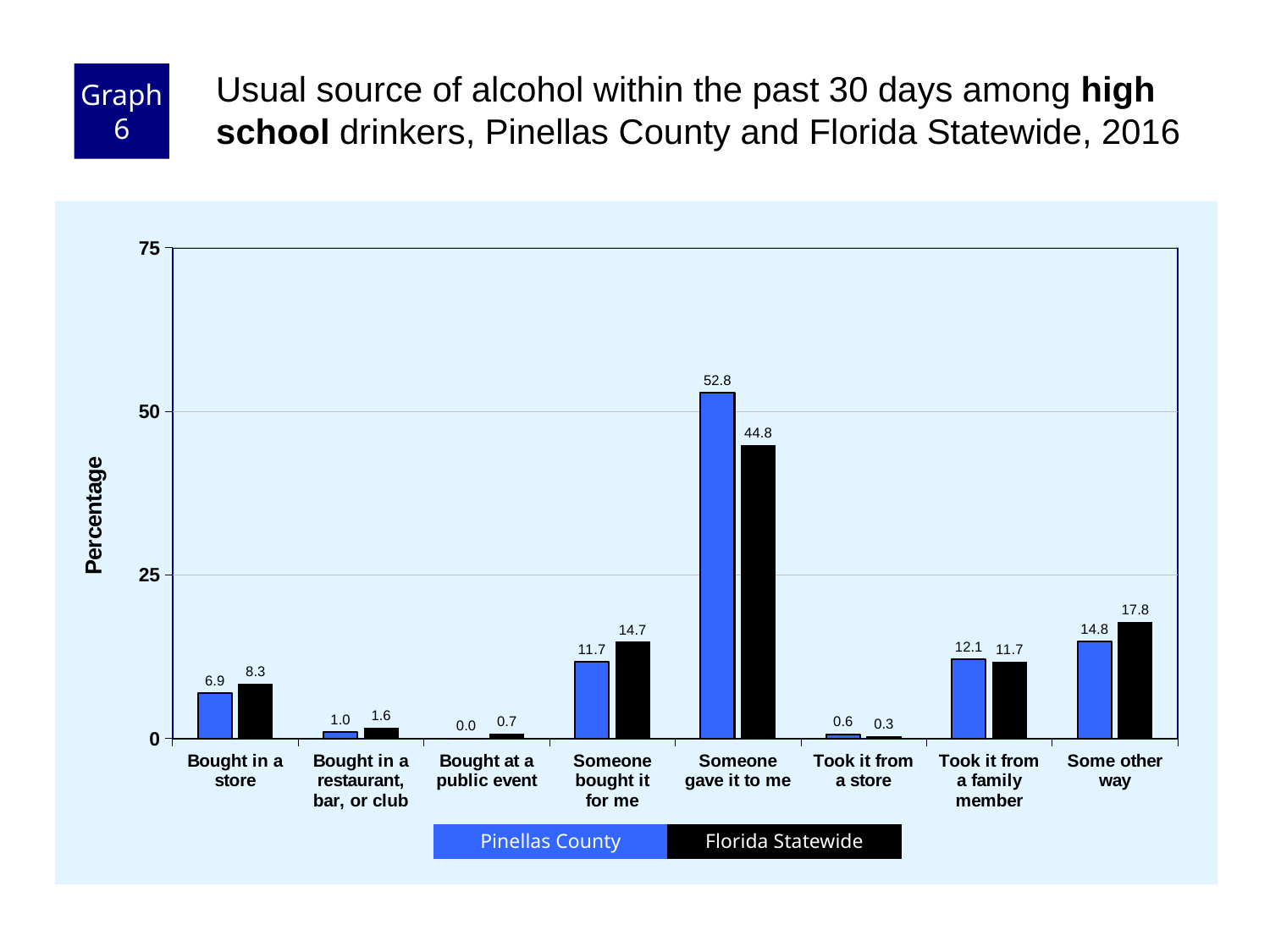
What is the label of the y axis? Percentage Which category has the highest Florida Statewide value? Someone gave it to me What is the difference between the Pinellas County and Florida Statewide values for "Someone gave it to me"? 8.0 What is the Florida Statewide value for "Some other way"? 17.8 How many series does the legend list? 2 Is the Florida Statewide value for "Someone gave it to me" greater or less than 50? less Which category has the lowest Pinellas County value? Bought at a public event How many categories are shown on the x axis? 8 What is the Pinellas County value for "Someone gave it to me"? 52.8 Which is larger for "Took it from a family member": Pinellas County or Florida Statewide? Pinellas County What kind of chart is shown on the slide? Bar chart What is the Pinellas County value for "Bought at a public event"? 0.0